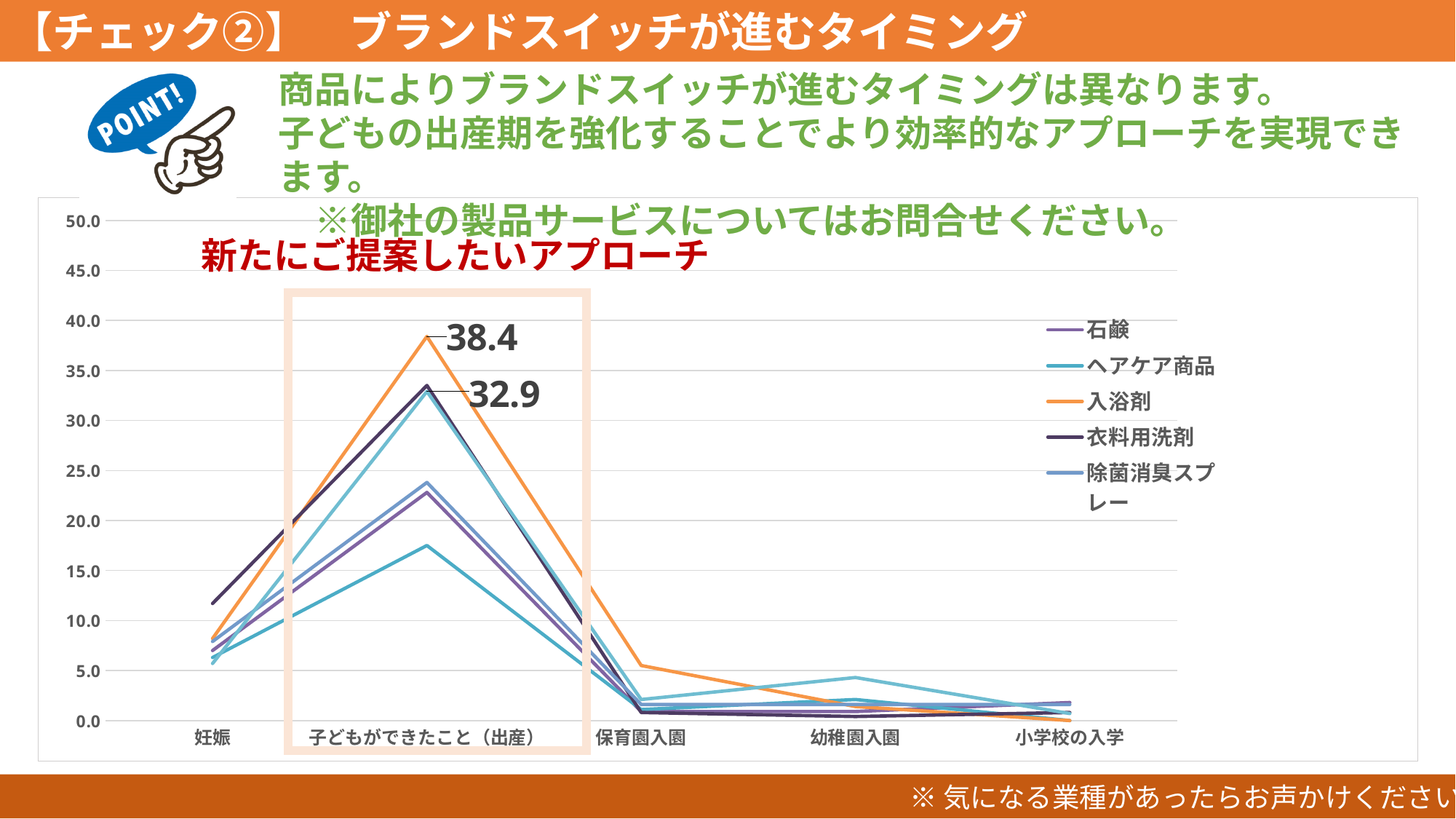
Is the value for ヘアケア商品 at 子どもができたこと（出産） greater or less than 20.0? less Is the value for 衣料用洗剤 at 妊娠 greater or less than 10.0? greater What kind of chart is shown on the slide? line chart How many series does the legend list? 5 What is the highest data label printed on the chart? 38.4 What is the difference between the two printed data labels, 38.4 and 32.9? 5.5 How many categories are on the x axis? 5 Which category is highlighted with an orange box on the chart? 子どもができたこと（出産） Which series has the lowest value at 子どもができたこと（出産）? ヘアケア商品 Which series reaches the value 38.4 at 子どもができたこと（出産）? 入浴剤 Does the 入浴剤 line rise or fall from 子どもができたこと（出産） to 保育園入園? fall Which series has the highest value at 子どもができたこと（出産）? 入浴剤